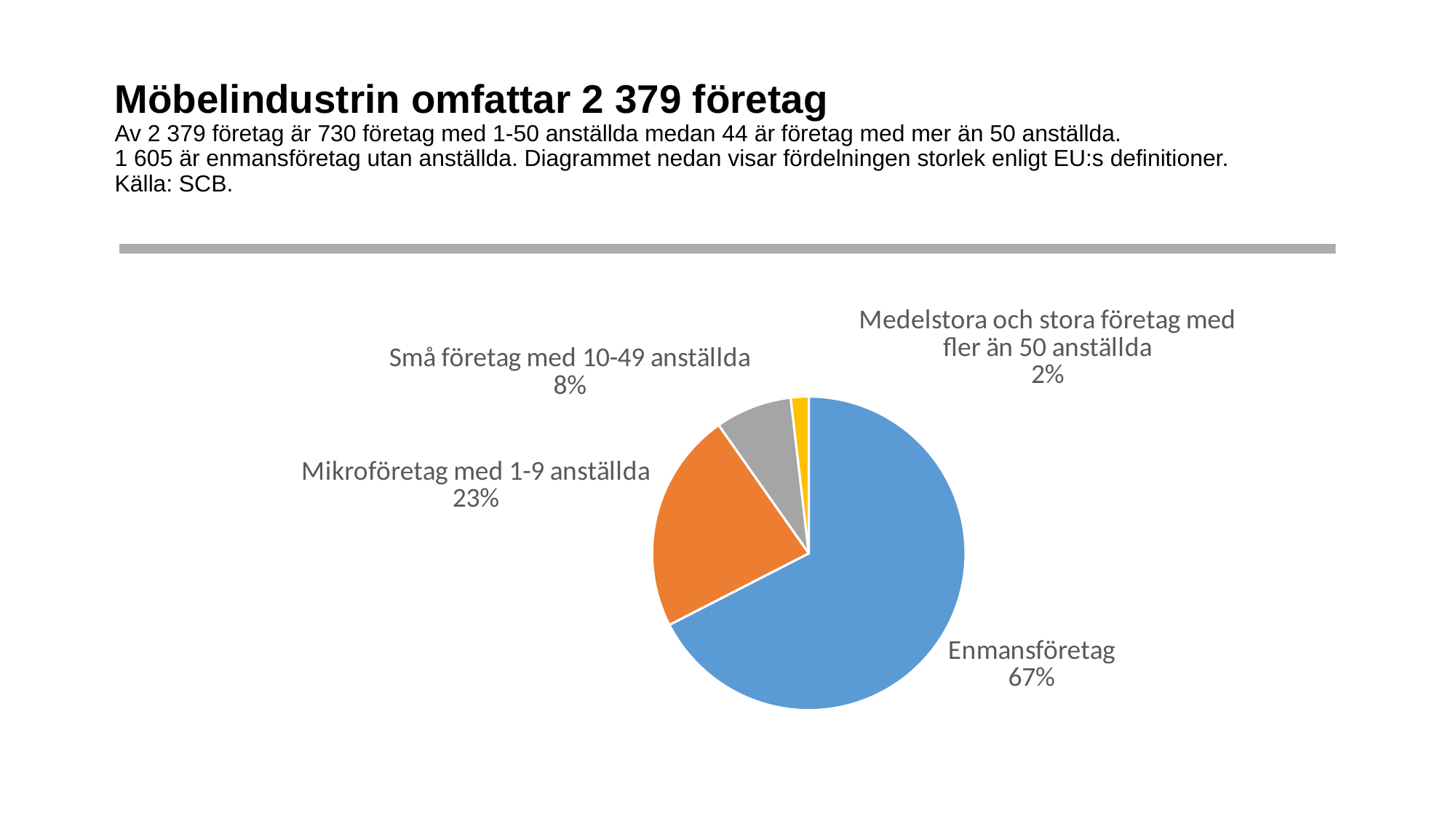
What colour is the slice for Enmansföretag? Blue What kind of chart is shown on the slide? Pie chart How many slices does the pie chart have? 4 Which category has the largest slice of the pie? Enmansföretag What share of the pie does Mikroföretag med 1-9 anställda represent? 23% What is the difference in percentage points between Enmansföretag and Mikroföretag med 1-9 anställda? 44 What share of the pie does Enmansföretag represent? 67% Which is larger, the share for Små företag med 10-49 anställda or the share for Medelstora och stora företag med fler än 50 anställda? Små företag med 10-49 anställda What share of the pie does Små företag med 10-49 anställda represent? 8% Which category has the smallest slice of the pie? Medelstora och stora företag med fler än 50 anställda What colour is the slice for Mikroföretag med 1-9 anställda? Orange